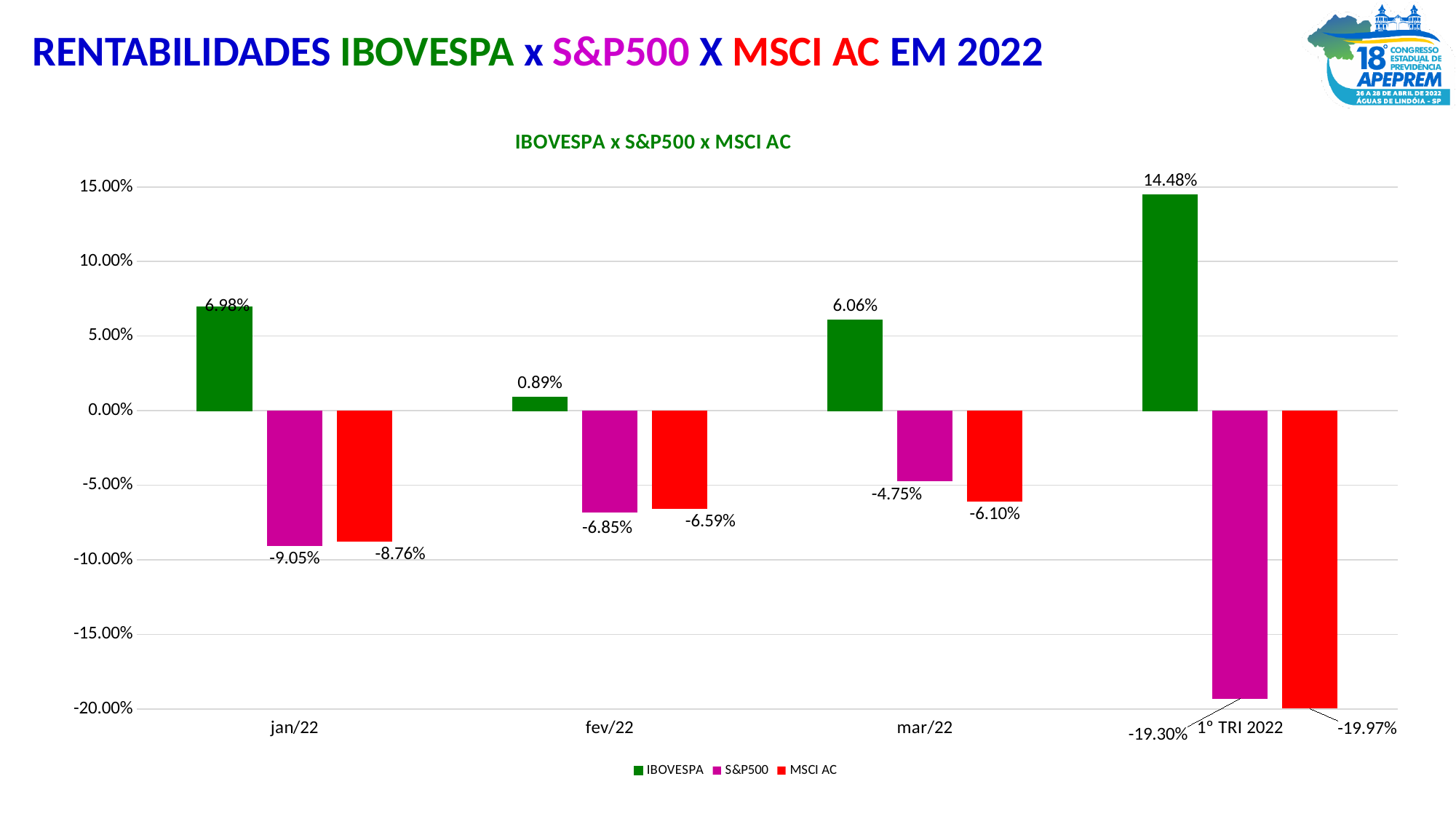
What is the IBOVESPA value for jan/22? 6.98% What colour represents the S&P500 series? Magenta Which is larger in fev/22, the S&P500 value or the MSCI AC value? MSCI AC Which category has the lowest MSCI AC value? 1° TRI 2022 What is the S&P500 value for 1° TRI 2022? -19.30% How many categories are shown on the x axis? 4 What is the difference between the IBOVESPA value for jan/22 and the IBOVESPA value for mar/22? 0.92% How many series does the legend list? 3 What is the MSCI AC value for mar/22? -6.10% What is the S&P500 value for fev/22? -6.85% What kind of chart is shown on the slide? Bar chart Which category has the highest IBOVESPA value? 1° TRI 2022